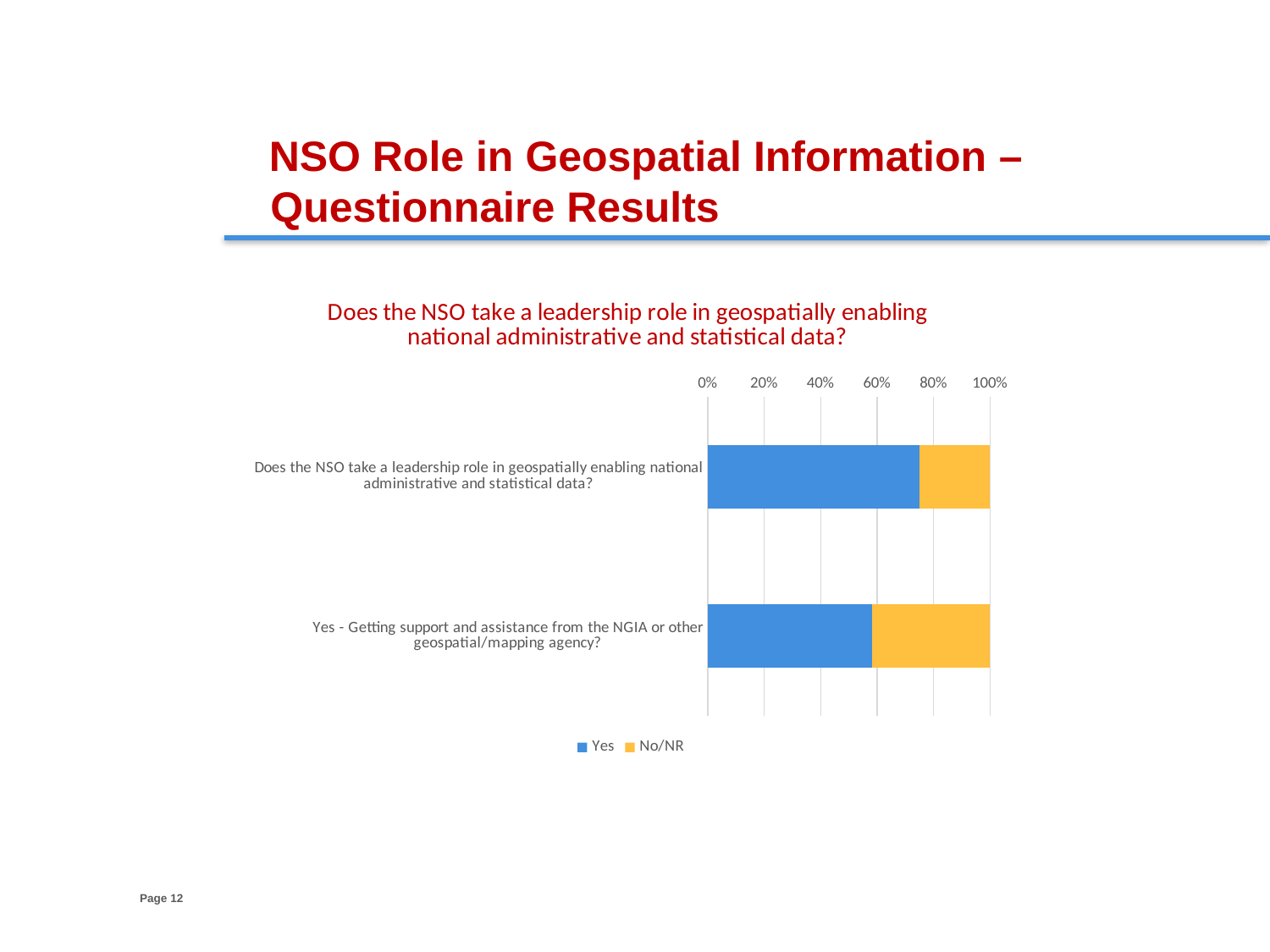
Is the 'Yes' value for 'Yes - Getting support and assistance from the NGIA or other geospatial/mapping agency?' greater or less than 40%? greater Is the 'No/NR' value for 'Does the NSO take a leadership role in geospatially enabling national administrative and statistical data?' greater or less than 40%? less What kind of chart is shown on the slide? bar chart Which category has the larger 'No/NR' share? Yes - Getting support and assistance from the NGIA or other geospatial/mapping agency? How many series does the legend list? 2 How many categories are plotted on the chart? 2 What is the title of the chart? Does the NSO take a leadership role in geospatially enabling national administrative and statistical data? Is the 'Yes' value for 'Yes - Getting support and assistance from the NGIA or other geospatial/mapping agency?' greater or less than 80%? less What are the two series named in the legend? Yes and No/NR Which category has the larger 'Yes' share? Does the NSO take a leadership role in geospatially enabling national administrative and statistical data? For 'Does the NSO take a leadership role in geospatially enabling national administrative and statistical data?', which is larger, the 'Yes' share or the 'No/NR' share? Yes